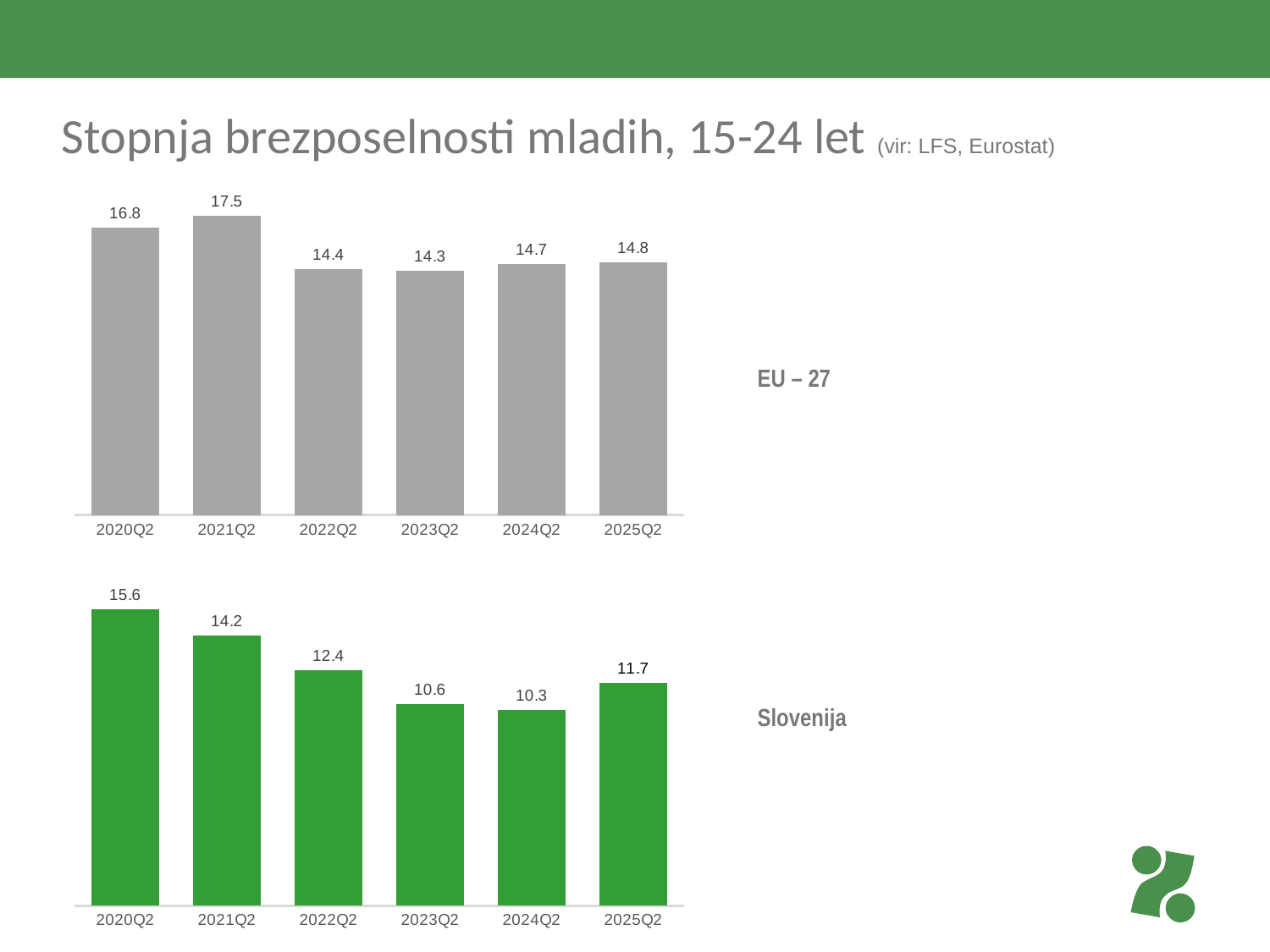
In the Slovenija chart, which period has the highest value? 2020Q2 What colour are the bars in the EU – 27 chart? Grey What type of chart is the Slovenija chart? Bar chart In the EU – 27 chart, what is the difference between the 2021Q2 and 2022Q2 values? 3.1 In the EU – 27 chart, which period has the lowest value? 2023Q2 In the Slovenija chart, what is the value for 2024Q2? 10.3 What is the title of the slide containing the two charts? Stopnja brezposelnosti mladih, 15-24 let In the Slovenija chart, which is larger, the value for 2023Q2 or 2025Q2? 2025Q2 How many periods are shown on the x axis of the EU – 27 chart? 6 In the Slovenija chart, what is the difference between the 2020Q2 and 2025Q2 values? 3.9 In the EU – 27 chart, what is the value for 2021Q2? 17.5 In the Slovenija chart, do the values rise or fall from 2020Q2 to 2024Q2? Fall